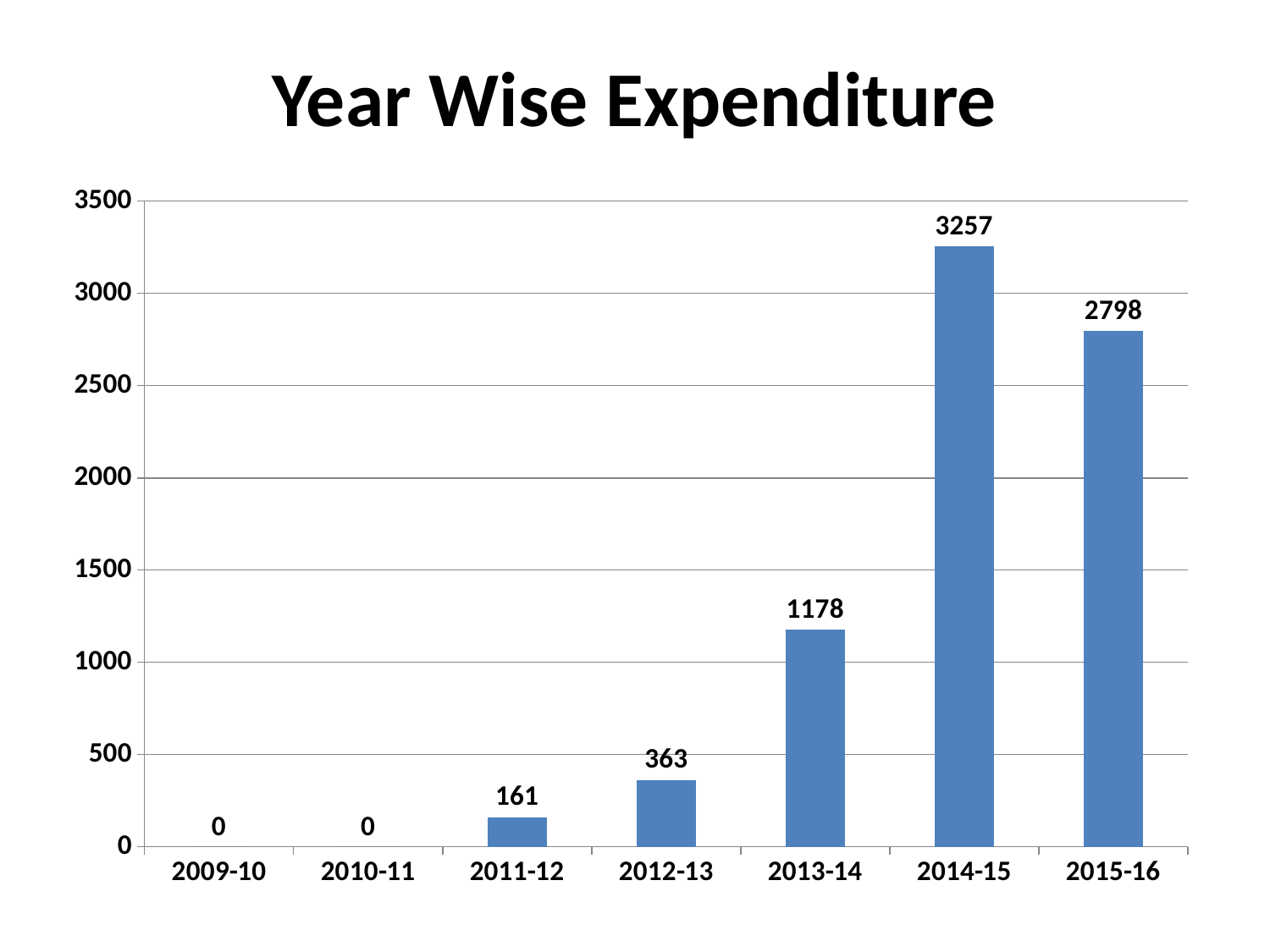
How many years are shown on the x axis? 7 Is the value for 2013-14 greater or less than 1000? greater What is the expenditure for 2011-12? 161 What kind of chart is shown on the slide? Bar chart What is the difference in expenditure between 2014-15 and 2015-16? 459 What is the expenditure for 2012-13? 363 How many years show an expenditure of 0? 2 Which is larger, the expenditure for 2013-14 or for 2015-16? 2015-16 What is the expenditure for 2014-15? 3257 What is the difference in expenditure between 2013-14 and 2012-13? 815 What is the title of the chart? Year Wise Expenditure Which year has the highest expenditure? 2014-15